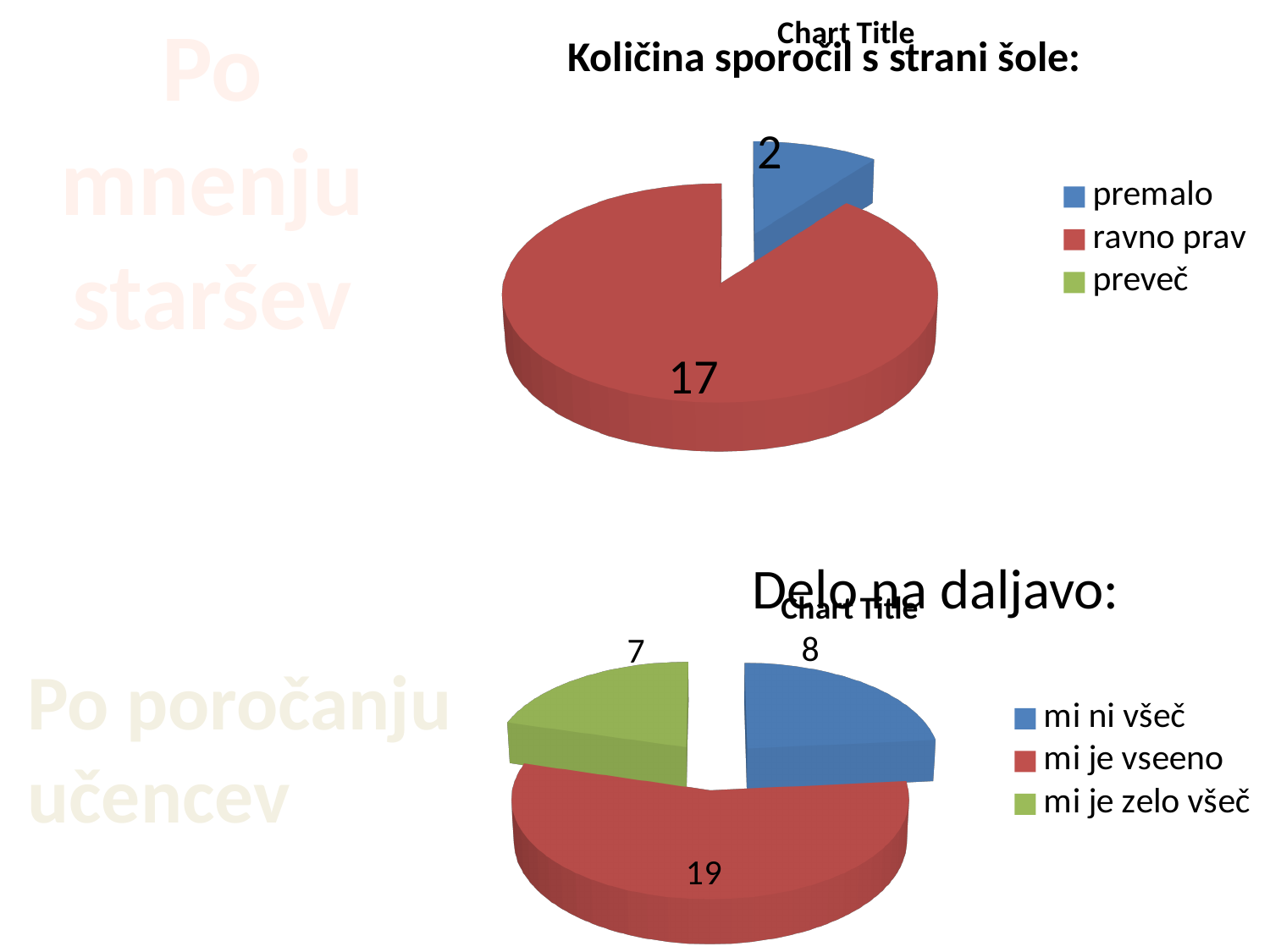
In the bottom chart (Delo na daljavo), which colour represents 'mi je zelo všeč'? green In the bottom chart (Delo na daljavo), what is the value for 'mi je zelo všeč'? 7 In the top chart (Količina sporočil s strani šole), what is the value for 'premalo'? 2 In the top chart (Količina sporočil s strani šole), what is the difference between 'ravno prav' and 'premalo'? 15 What kind of chart is the top chart (Količina sporočil s strani šole)? pie chart In the bottom chart (Delo na daljavo), what is the value for 'mi je vseeno'? 19 In the top chart (Količina sporočil s strani šole), which category has the largest slice? ravno prav In the top chart (Količina sporočil s strani šole), what is the value for 'ravno prav'? 17 In the bottom chart (Delo na daljavo), which category has the smallest value? mi je zelo všeč How many entries does the legend of the top chart (Količina sporočil s strani šole) list? 3 In the bottom chart (Delo na daljavo), how many slices does the pie have? 3 In the bottom chart (Delo na daljavo), what is the difference between 'mi je vseeno' and 'mi ni všeč'? 11